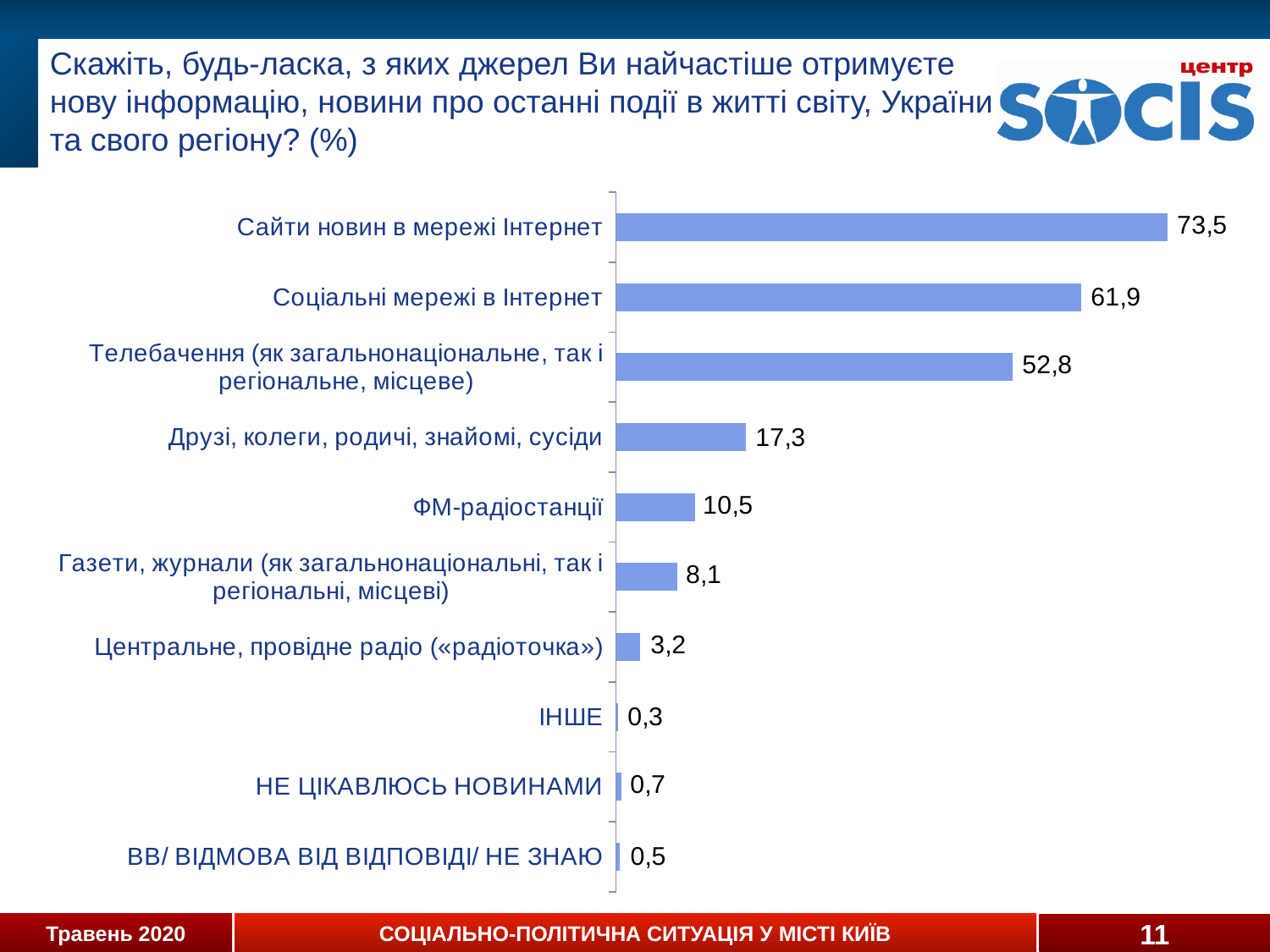
What value is shown for "Центральне, провідне радіо («радіоточка»)"? 3,2 What is the difference between the values for "Друзі, колеги, родичі, знайомі, сусіди" and "ФМ-радіостанції"? 6,8 What kind of chart is shown on the slide? Bar chart Which category has the highest value? Сайти новин в мережі Інтернет How many categories are shown in the chart? 10 Which category has the lowest value? ІНШЕ What value is shown for "НЕ ЦІКАВЛЮСЬ НОВИНАМИ"? 0,7 What value is shown for "ФМ-радіостанції"? 10,5 What value is shown for "Соціальні мережі в Інтернет"? 61,9 Which is larger: the value for "Телебачення (як загальнонаціональне, так і регіональне, місцеве)" or for "Друзі, колеги, родичі, знайомі, сусіди"? Телебачення (як загальнонаціональне, так і регіональне, місцеве) What is the difference between the values for "Сайти новин в мережі Інтернет" and "Соціальні мережі в Інтернет"? 11,6 What value is shown for "Сайти новин в мережі Інтернет"? 73,5